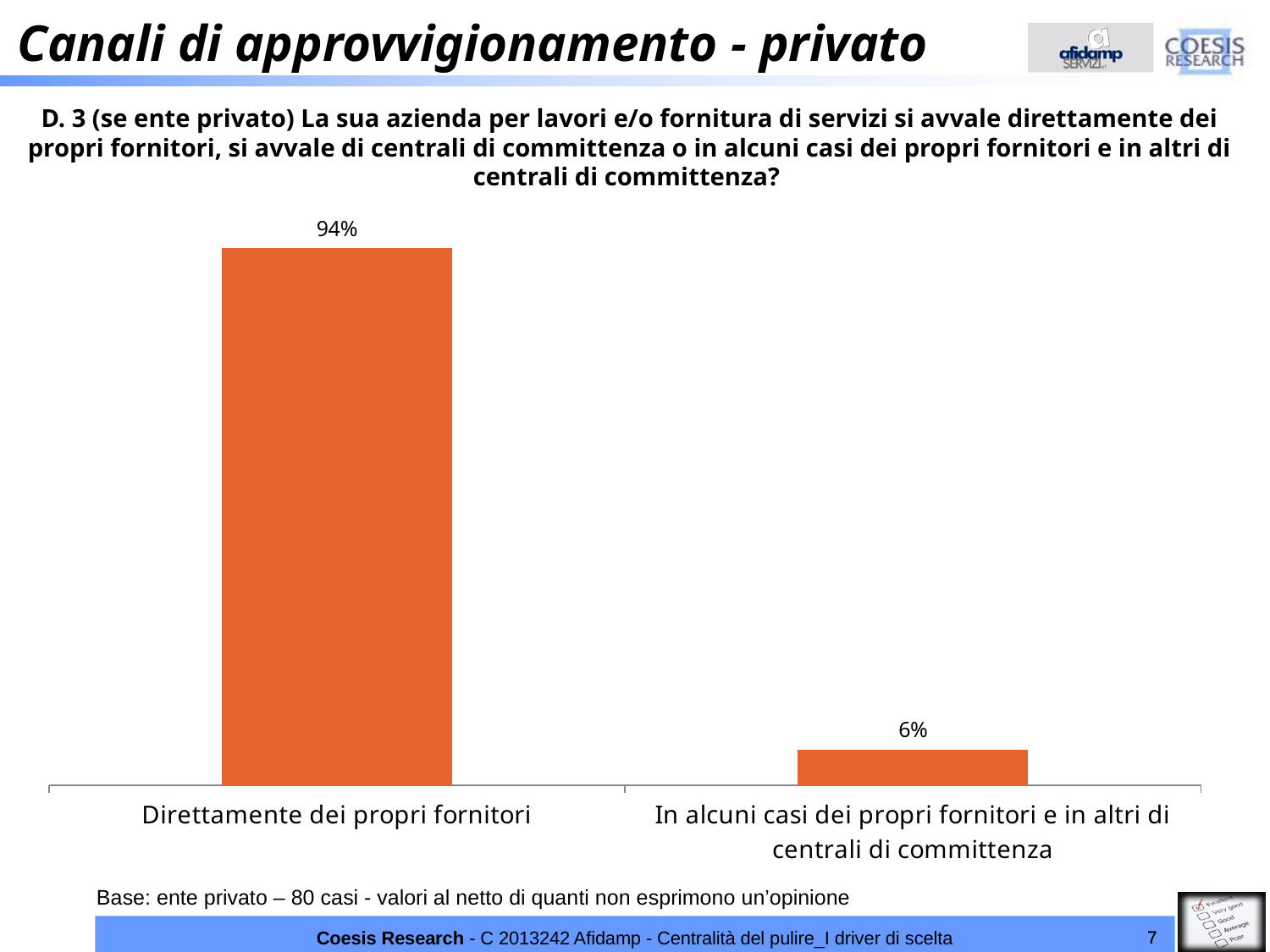
Which is larger: the value for "Direttamente dei propri fornitori" or the value for "In alcuni casi dei propri fornitori e in altri di centrali di committenza"? Direttamente dei propri fornitori What is the value for "In alcuni casi dei propri fornitori e in altri di centrali di committenza"? 6% Which category has the lowest value? In alcuni casi dei propri fornitori e in altri di centrali di committenza What kind of chart is shown on the slide? Bar chart What is the value for "Direttamente dei propri fornitori"? 94% What is the total of the two values shown in the chart? 100% What is the difference between the value for "Direttamente dei propri fornitori" and the value for "In alcuni casi dei propri fornitori e in altri di centrali di committenza"? 88% How many categories are shown in the chart? 2 Which category has the highest value? Direttamente dei propri fornitori What colour are the bars in the chart? Orange According to the note below the chart, how many cases form the base for the chart? 80 casi